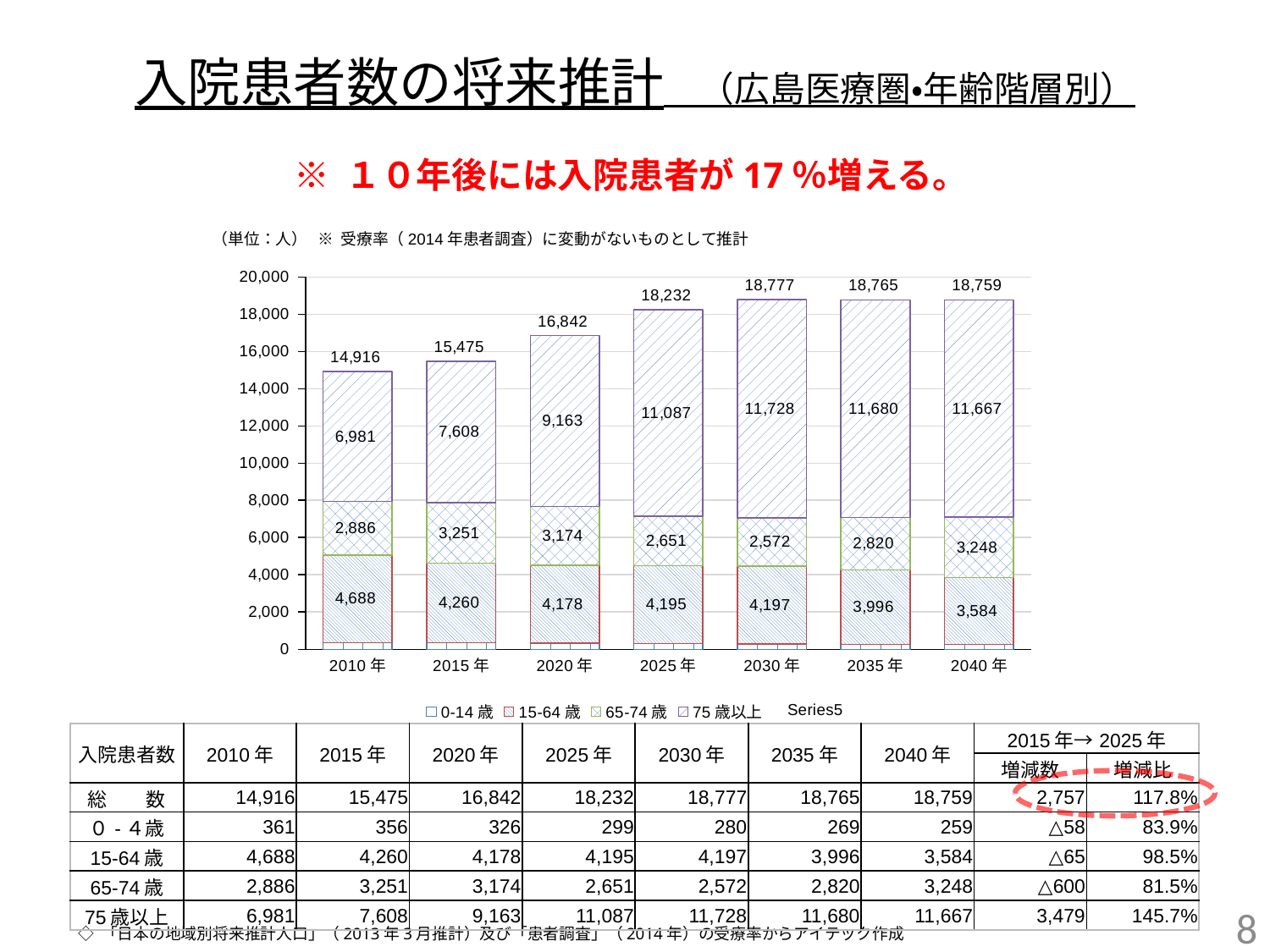
How many years (categories) are plotted along the x axis of the chart? 7 What is the total number of inpatients shown above the bar for 2025年? 18,232 Which year has the lowest total number of inpatients? 2010年 What is the difference between the total for 2030年 and the total for 2010年? 3,861 What type of chart is shown on the slide? Stacked bar chart What is the value for the 75歳以上 segment in 2020年? 9,163 What is the value for the 65-74歳 segment in 2015年? 3,251 Is the total for 2020年 greater or less than 16,000? greater Is the 75歳以上 segment larger in 2025年 or in 2015年? 2025年 What is the value for the 15-64歳 segment in 2040年? 3,584 Which year has the highest total number of inpatients? 2030年 How many series does the chart legend list? 5